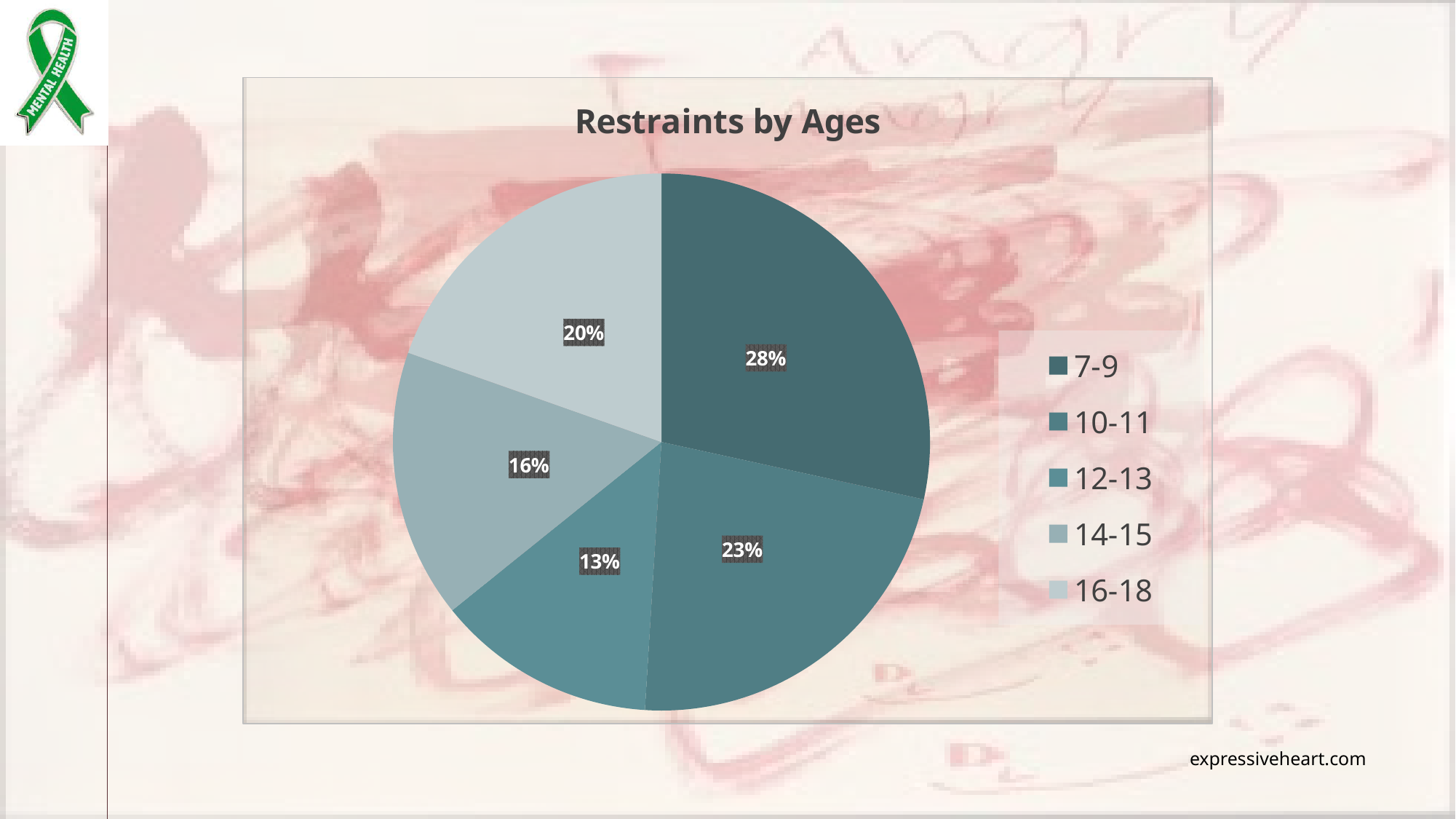
What share of restraints is for ages 16-18? 20% Which age group has the largest share of restraints? 7-9 What share of restraints is for ages 14-15? 16% What share of restraints is for ages 7-9? 28% What type of chart is shown on the slide? pie chart What is the difference in percentage points between the 7-9 and 12-13 age groups? 15 How many age groups are shown in the pie chart? 5 Which age group has the smallest share of restraints? 12-13 Which age group has a larger share, 14-15 or 16-18? 16-18 What is the title of the chart? Restraints by Ages